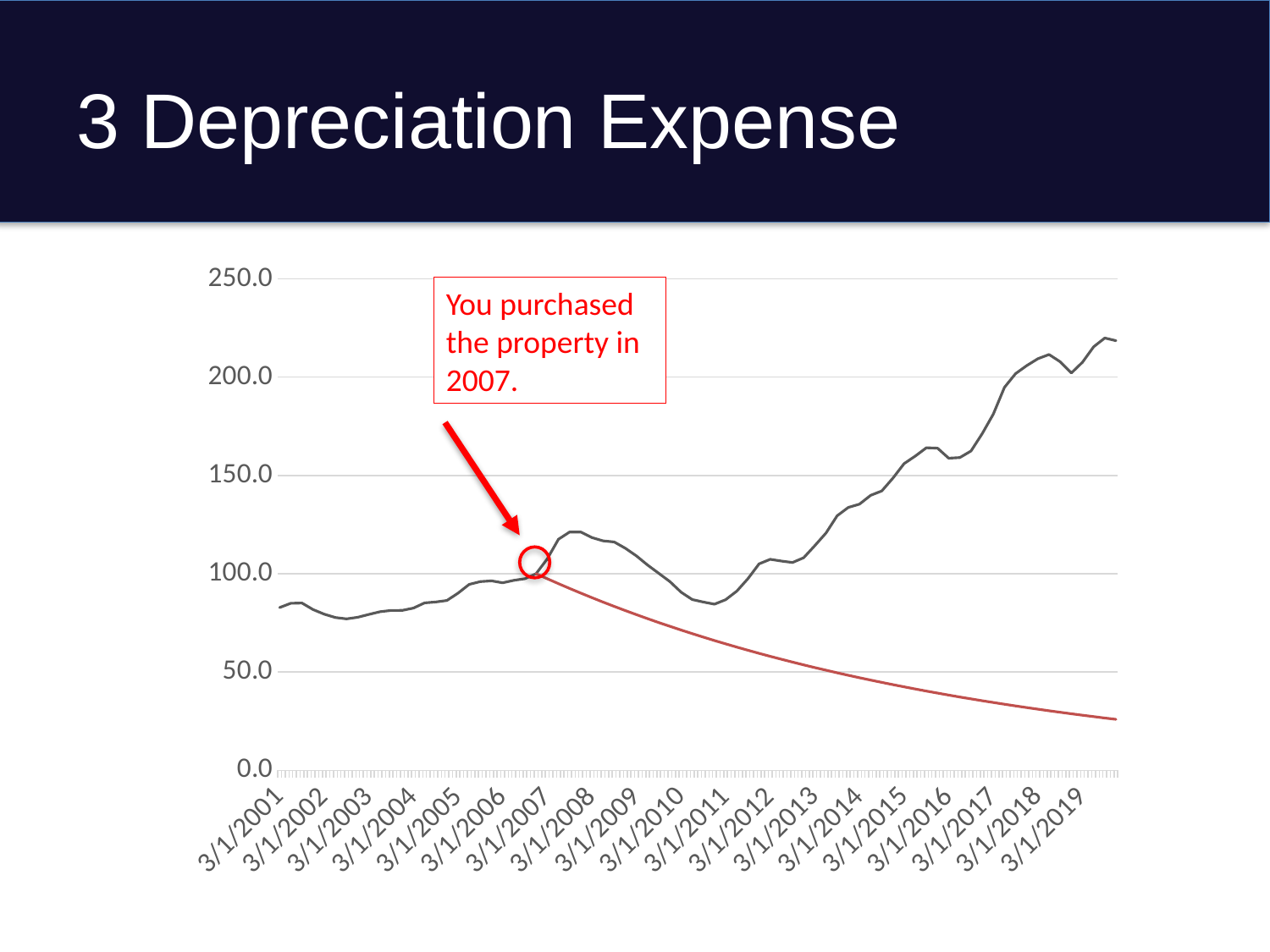
Is the value of the black line at 3/1/2008 greater or less than 100? greater Does the red line rise or fall from 3/1/2007 to 3/1/2019? fall What does the text box annotation on the chart say? You purchased the property in 2007. What kind of chart is shown on the slide? line chart Does the black line rise or fall overall from 3/1/2001 to 3/1/2019? rise Is the value of the red line at 3/1/2019 greater or less than 50? less Is the value of the black line at 3/1/2011 greater or less than 100? less How many dated labels are shown along the x axis? 19 What colour is the line that starts at the circled point in 2007 and declines to the right? red